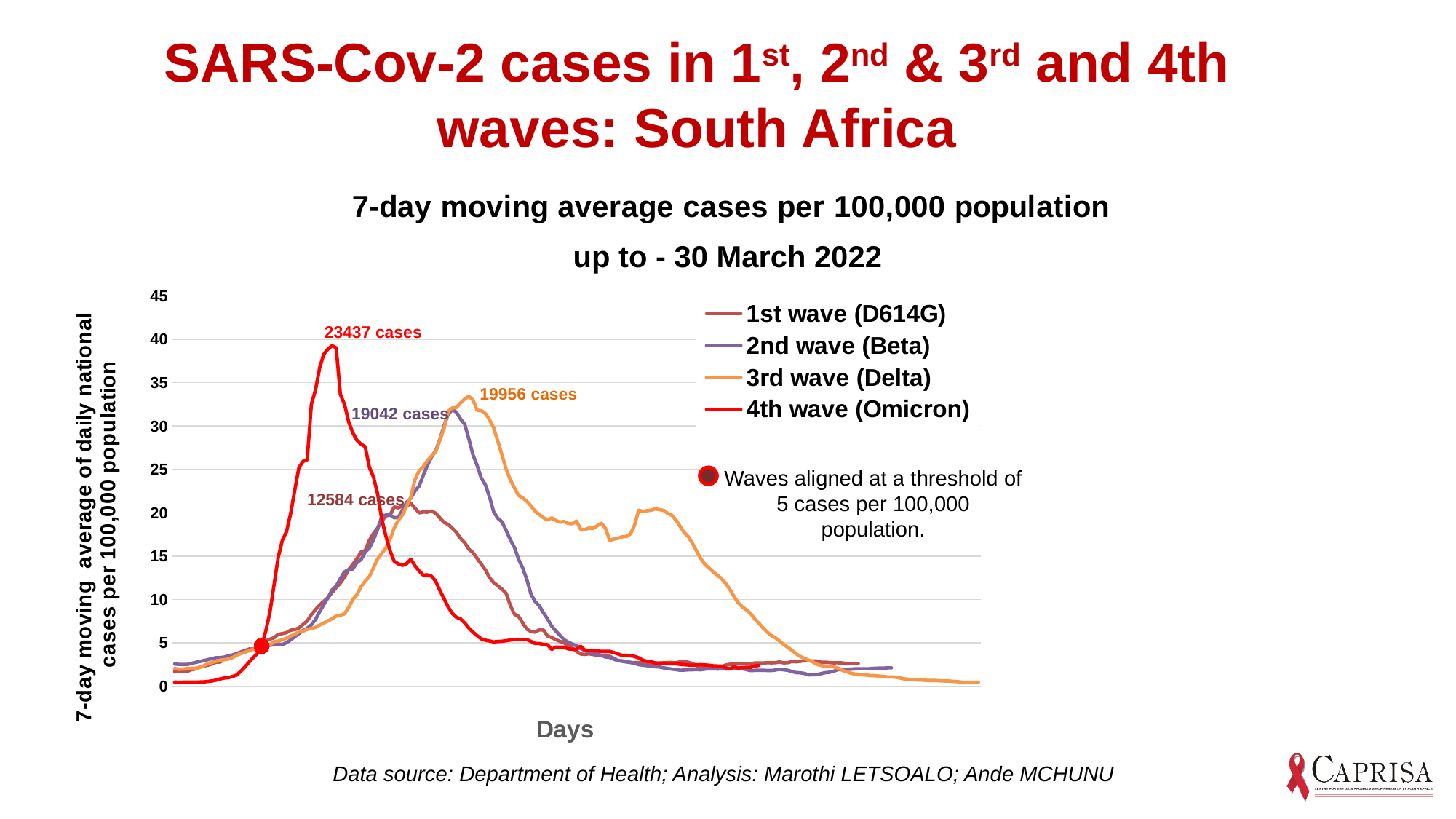
How many peak cases are labelled for the 3rd wave (Delta)? 19956 cases Which has a larger labelled peak number of cases, the 3rd wave (Delta) or the 2nd wave (Beta)? 3rd wave (Delta) What kind of chart is shown on the slide? line chart How many series does the legend list? 4 How many peak cases are labelled for the 1st wave (D614G)? 12584 cases How many peak cases are labelled for the 4th wave (Omicron)? 23437 cases What is the difference between the labelled peak cases of the 4th wave (Omicron) and the 3rd wave (Delta)? 3481 cases Which wave has the lowest labelled peak number of cases? 1st wave (D614G) How many peak cases are labelled for the 2nd wave (Beta)? 19042 cases Is the peak 7-day moving average per 100,000 population for the 4th wave (Omicron) greater or less than 35? greater Which wave has the highest labelled peak number of cases? 4th wave (Omicron) At what threshold of cases per 100,000 population are the waves aligned? 5 cases per 100,000 population